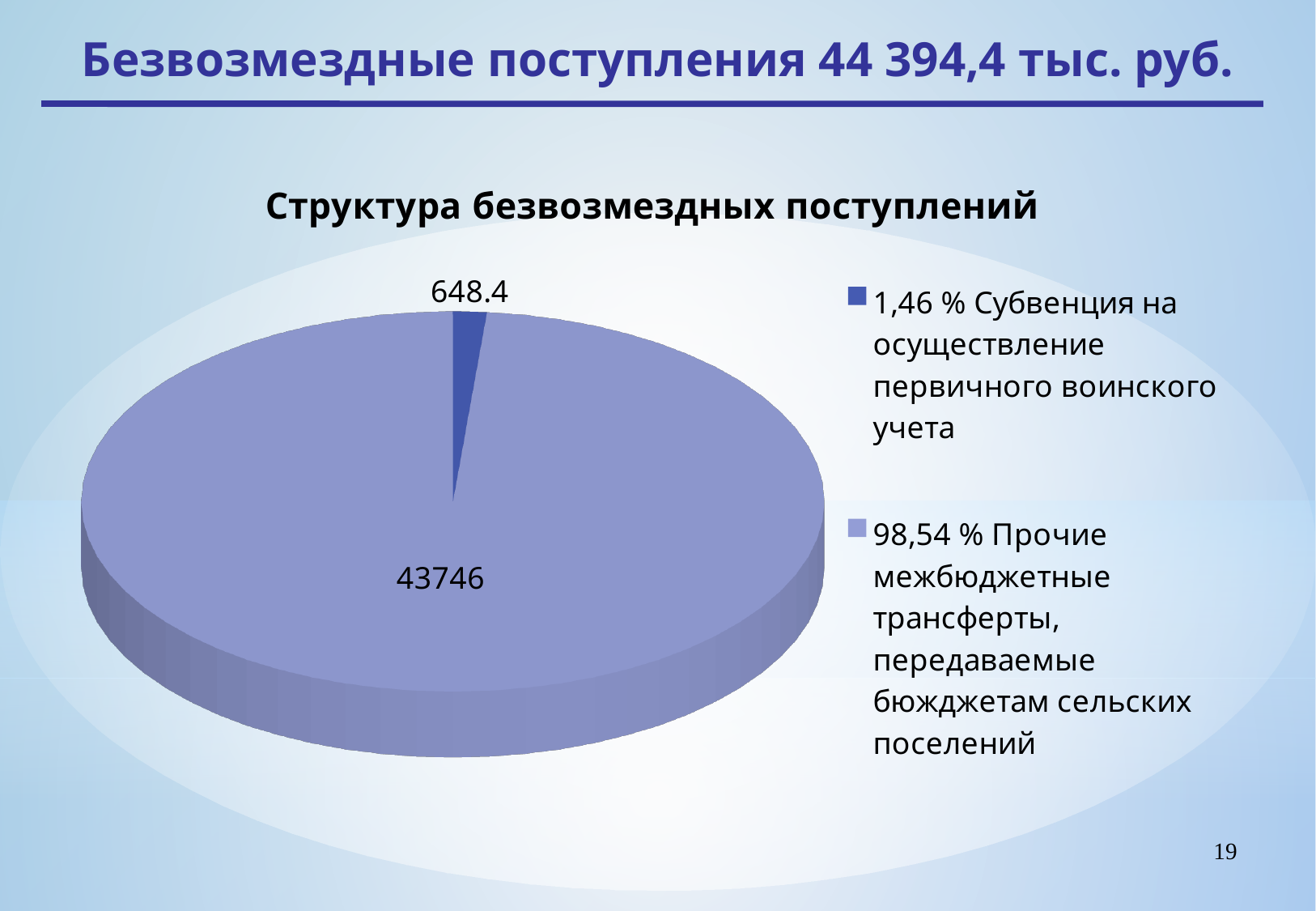
What is the value shown for Прочие межбюджетные трансферты, передаваемые бюджетам сельских поселений? 43746 What is the difference between the value for Прочие межбюджетные трансферты and the value for Субвенция на осуществление первичного воинского учета? 43097.6 How many slices does the pie chart have? 2 How many entries does the legend list? 2 Which category has the largest slice of the pie? Прочие межбюджетные трансферты, передаваемые бюджетам сельских поселений What share of the pie does Прочие межбюджетные трансферты, передаваемые бюджетам сельских поселений represent? 98,54 % What kind of chart is shown on the slide? Pie chart Which category has the smallest slice of the pie? Субвенция на осуществление первичного воинского учета Which is larger: the value for Субвенция на осуществление первичного воинского учета or the value for Прочие межбюджетные трансферты? Прочие межбюджетные трансферты What is the title of the chart? Структура безвозмездных поступлений What is the value shown for Субвенция на осуществление первичного воинского учета? 648.4 What share of the pie does Субвенция на осуществление первичного воинского учета represent? 1,46 %